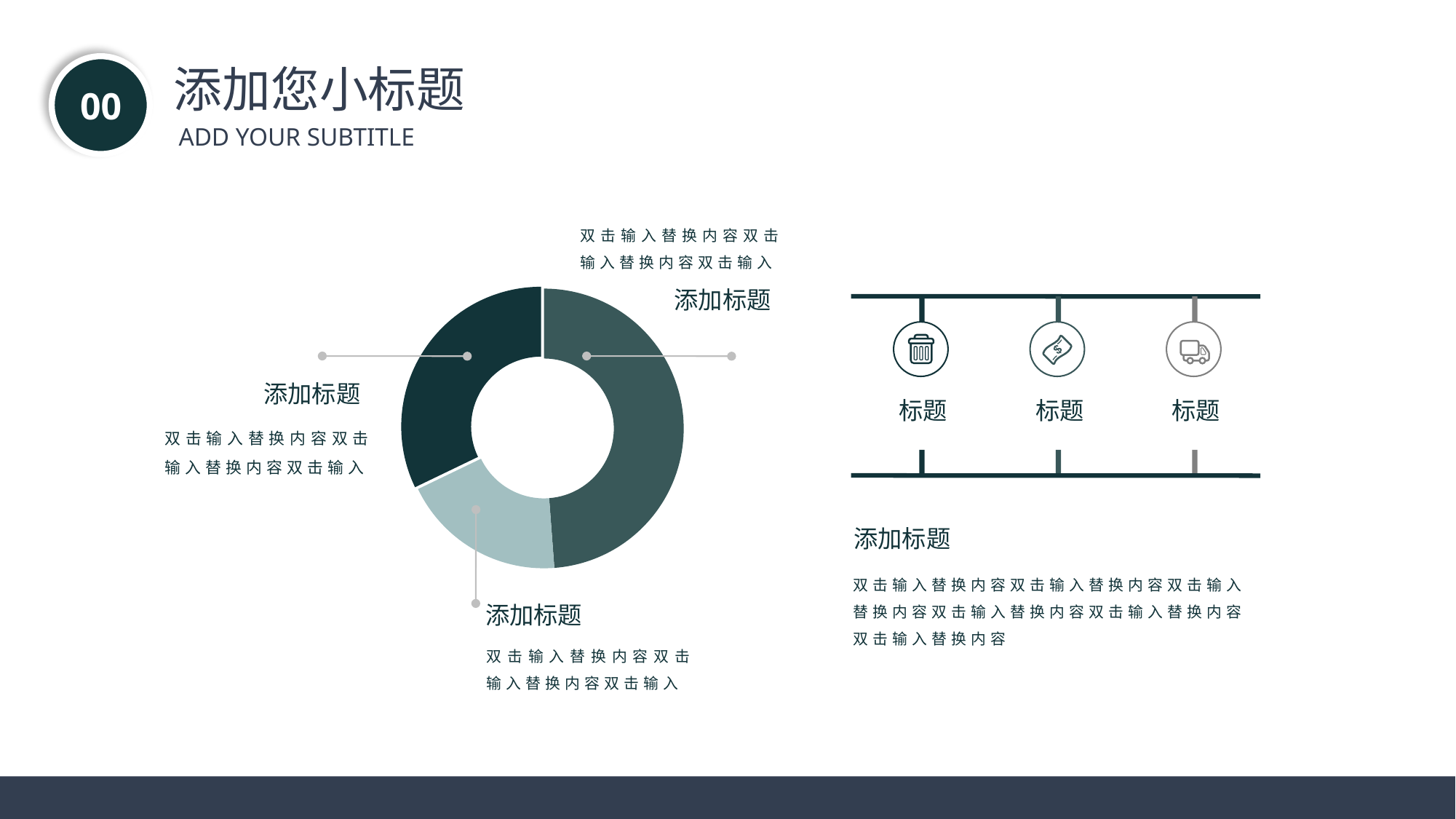
How many slices does the donut chart on the left have? 3 What kind of chart is shown on the left side of the slide? Donut chart Does the donut chart display any numeric data labels on its slices? No Which slice of the donut chart is the smallest: the dark navy slice, the medium green slice, or the light teal slice? The light teal slice Which slice of the donut chart is the largest: the dark navy slice, the medium green slice, or the light teal slice? The medium green slice In the donut chart, is the dark navy slice larger or smaller than the light teal slice? Larger What label text is shown next to each slice of the donut chart? 添加标题 In the donut chart, is the medium green slice larger or smaller than the dark navy slice? Larger